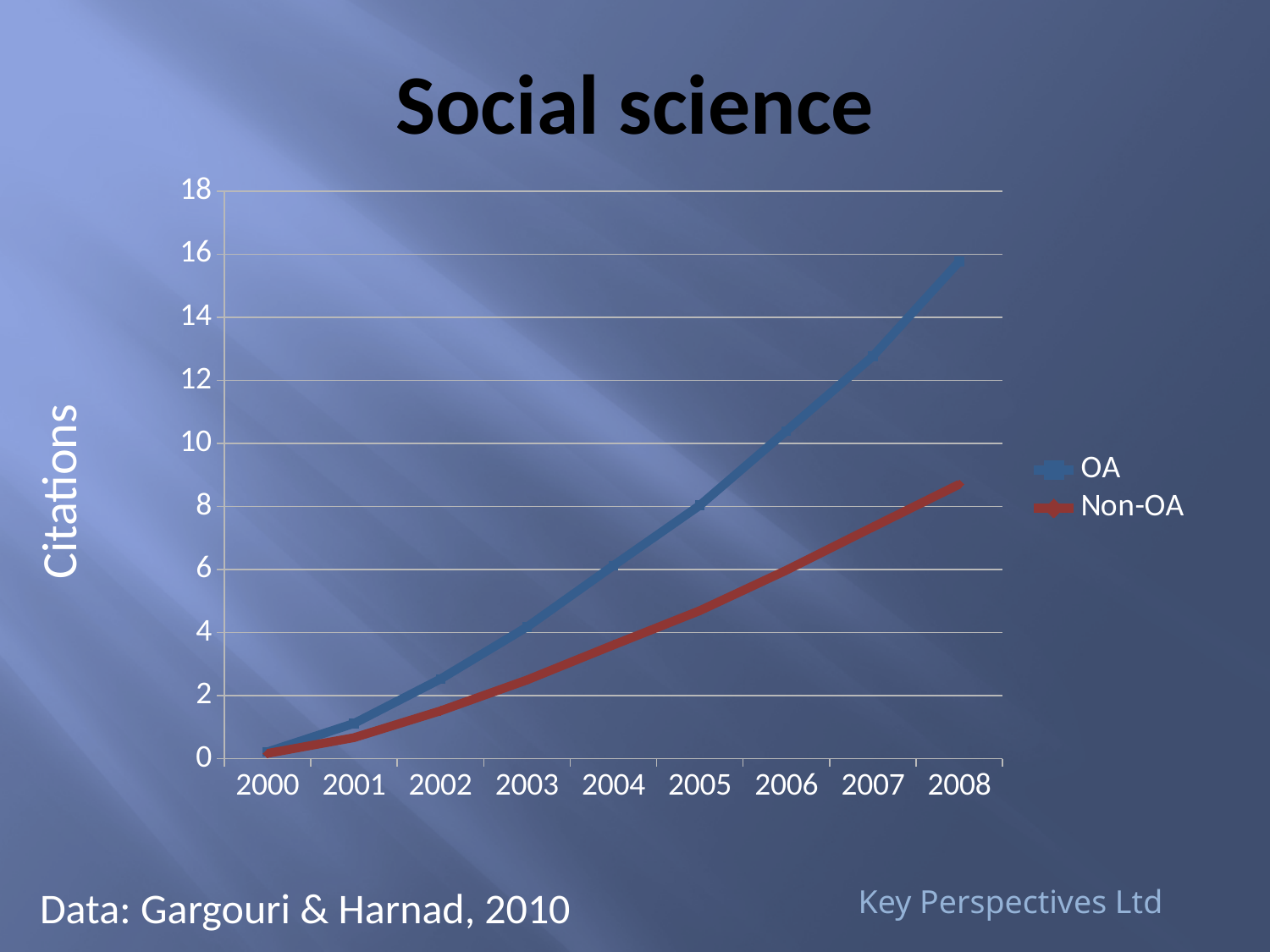
Which series has the higher value in 2008, OA or Non-OA? OA How many series does the legend list? 2 What is the label on the y axis? Citations Is the Non-OA value for 2007 greater or less than 8? less What is the title of the chart? Social science Is the OA value for 2008 greater or less than 14? greater What kind of chart is shown on the slide? line chart Is the Non-OA value for 2002 greater or less than 2? less How many years are shown along the x axis? 9 Do the OA citations rise or fall from 2000 to 2008? rise